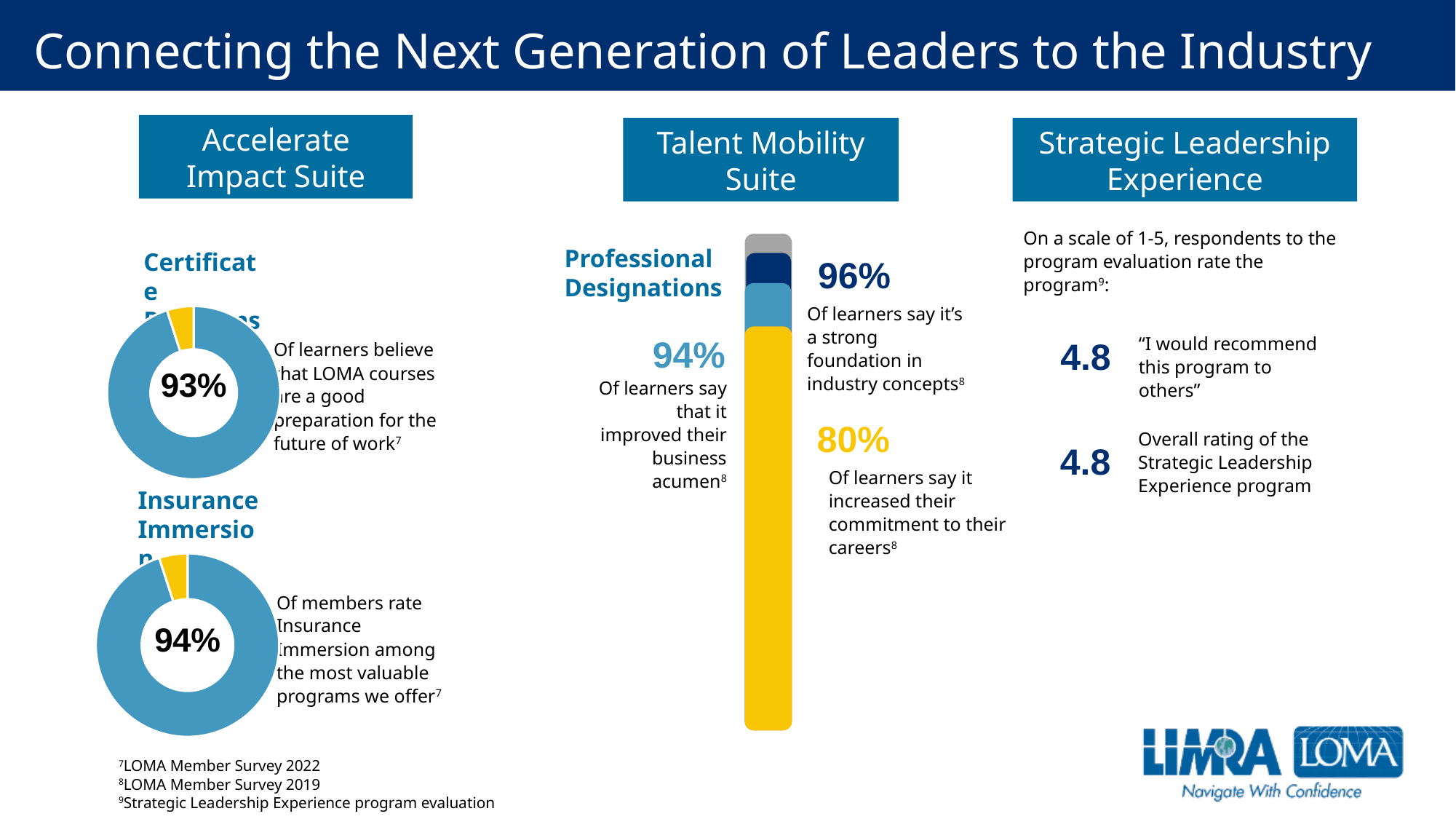
Is the value shown in the upper donut chart under Accelerate Impact Suite greater or less than 90%? greater How many coloured segments make up the Professional Designations stacked bar? 4 What value is shown in the centre of the upper donut chart under Accelerate Impact Suite? 93% Which colour segment is the largest in the Professional Designations stacked bar? Yellow Which colour segment is at the top of the Professional Designations stacked bar? Gray What is the difference between the percentage in the Insurance Immersion donut chart and the percentage in the upper donut chart? 1% What colour is the large filled portion of the Insurance Immersion donut chart? Blue How many donut charts are shown under the Accelerate Impact Suite heading? 2 What kind of chart is the upper chart under the Accelerate Impact Suite heading? Donut chart Which donut chart under Accelerate Impact Suite shows the larger percentage, the upper one or the Insurance Immersion one? Insurance Immersion What kind of chart is the Professional Designations chart under Talent Mobility Suite? Stacked bar chart What value is shown in the centre of the Insurance Immersion donut chart? 94%